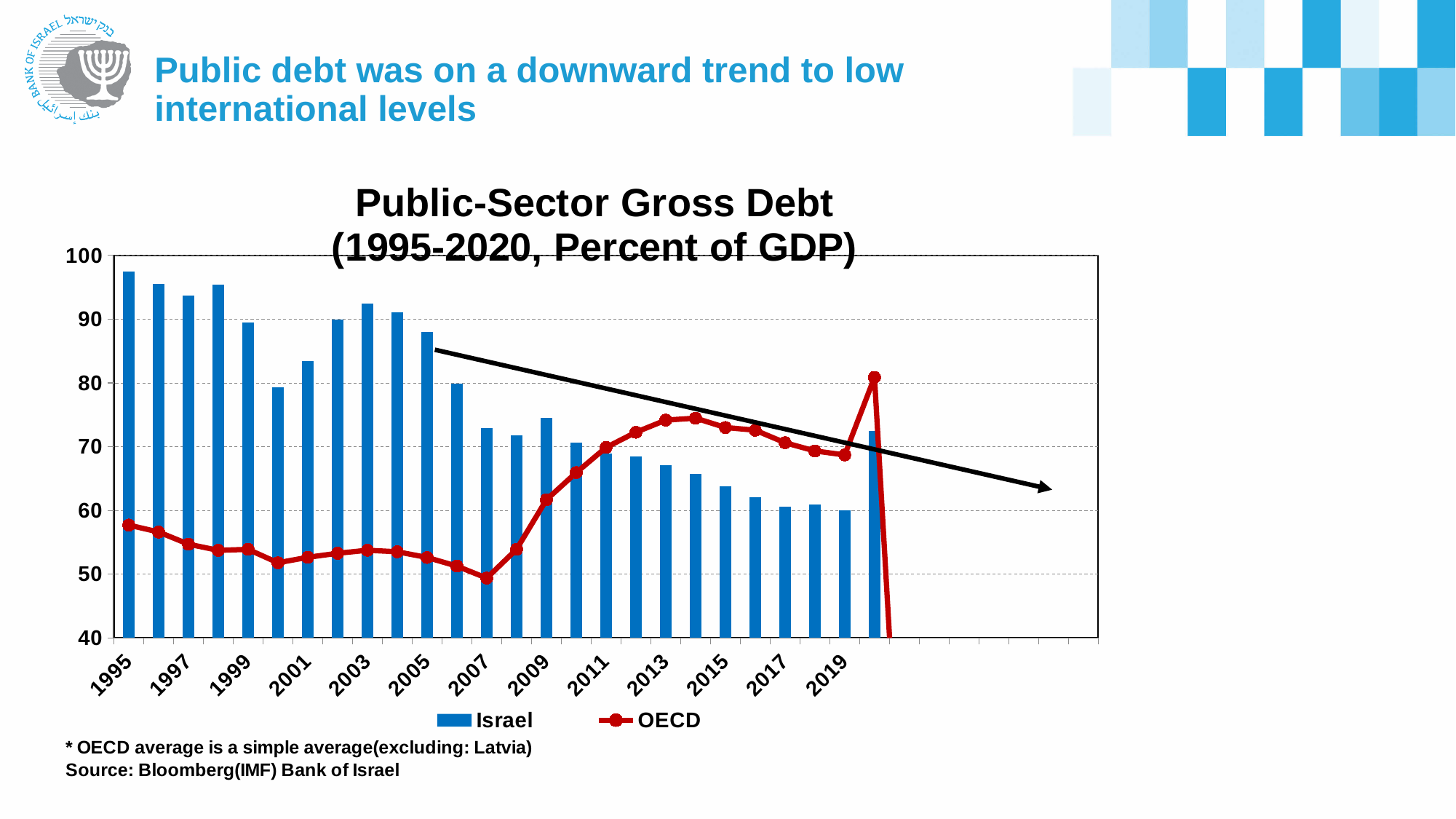
In which year does the OECD series reach its highest value? 2020 Do the Israel bars generally rise or fall from 2005 to 2019? fall Which series is drawn as a red line with markers? OECD Is the OECD value for 2013 greater or less than 70? greater How many series does the legend list? 2 What is the title of the chart? Public-Sector Gross Debt (1995-2020, Percent of GDP) What kind of chart is shown on the slide? A combination bar and line chart Is the OECD value for 1995 greater or less than 60? less Is the Israel value for 2001 greater or less than 80? greater In 2013, which is larger: the Israel value or the OECD value? OECD In which year does the OECD series reach its lowest value? 2007